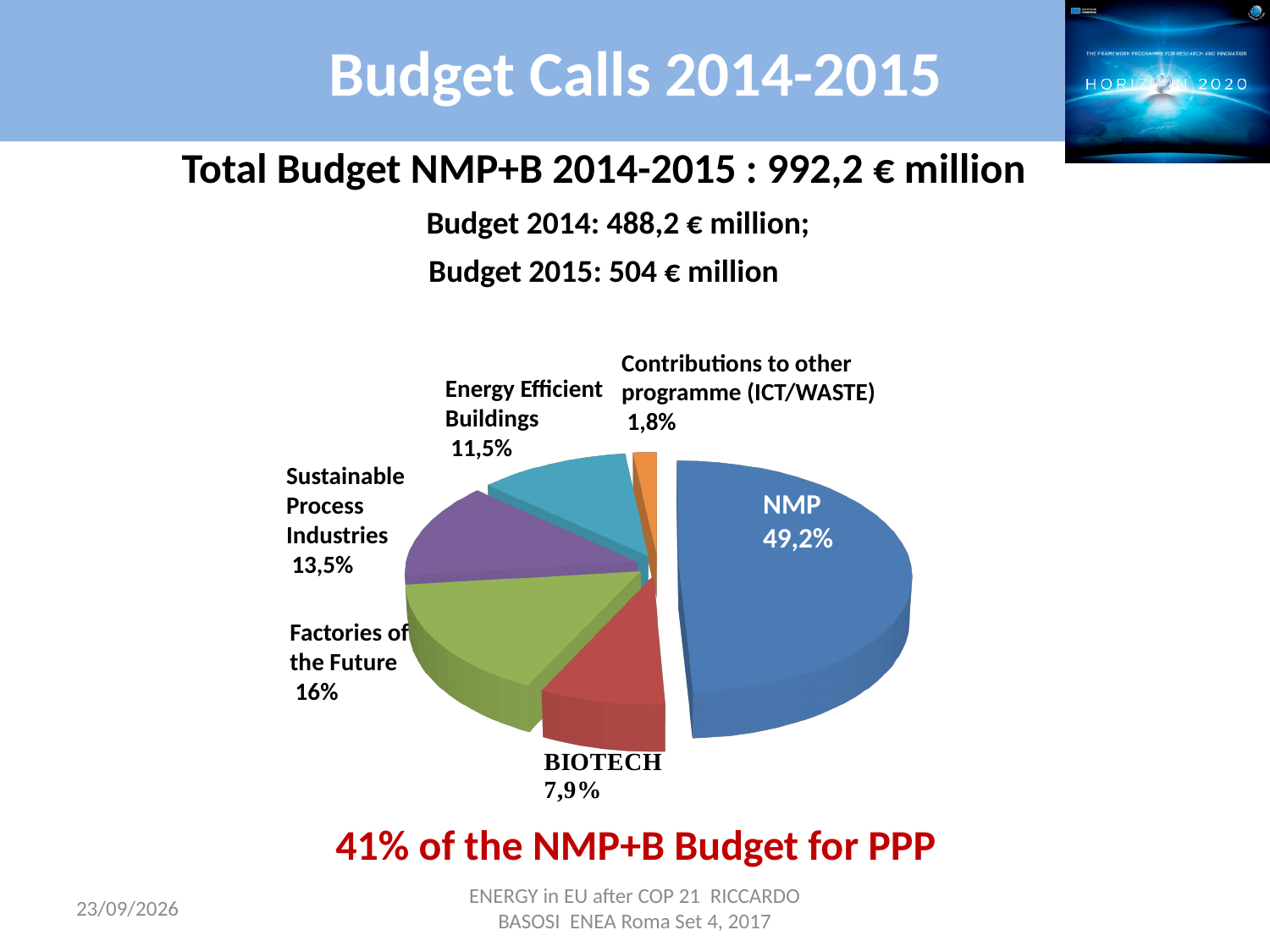
What kind of chart is shown on the slide? pie chart What share of the pie does Sustainable Process Industries have? 13,5% What share of the pie does Contributions to other programme (ICT/WASTE) have? 1,8% What share of the pie does Energy Efficient Buildings have? 11,5% Which slice of the pie is the largest? NMP Which is larger, the share for Factories of the Future or the share for Sustainable Process Industries? Factories of the Future Which slice of the pie is the smallest? Contributions to other programme (ICT/WASTE) What is the difference between the share for NMP and the share for BIOTECH? 41,3% How many slices does the pie chart have? 6